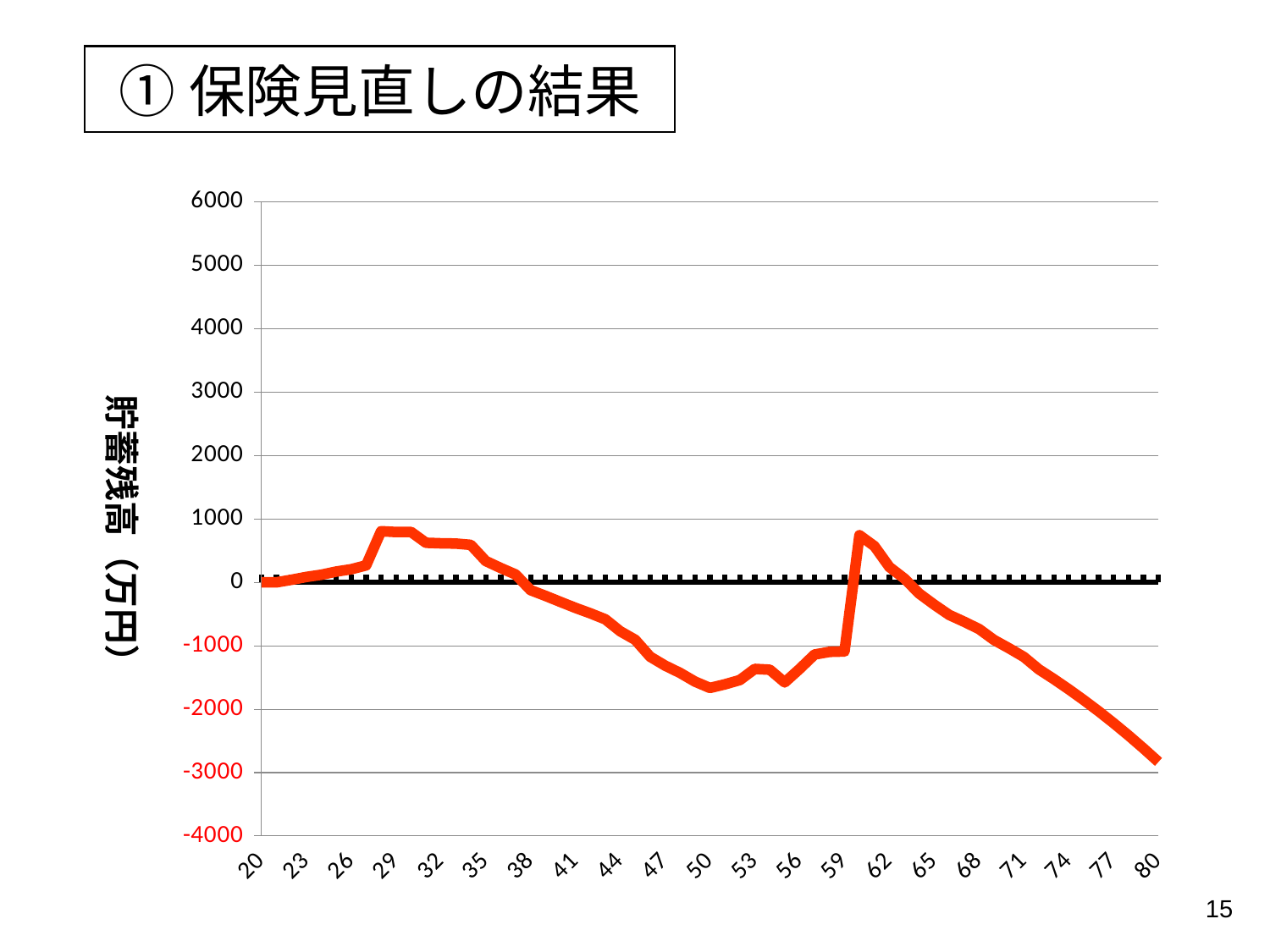
At which x-axis label is the plotted value lowest? 80 How many age labels are shown along the x axis? 21 Overall, does the plotted value rise or fall from age 20 to age 80? fall What is the label on the vertical axis of the chart? 貯蓄残高（万円） Is the value at age 50 greater or less than -1000? less Is the value at age 68 greater or less than 0? less Is the value at age 62 greater or less than 0? greater What kind of chart is shown on the slide? line chart Which is larger, the value at age 29 or the value at age 50? age 29 What is the title of the slide containing the chart? ① 保険見直しの結果